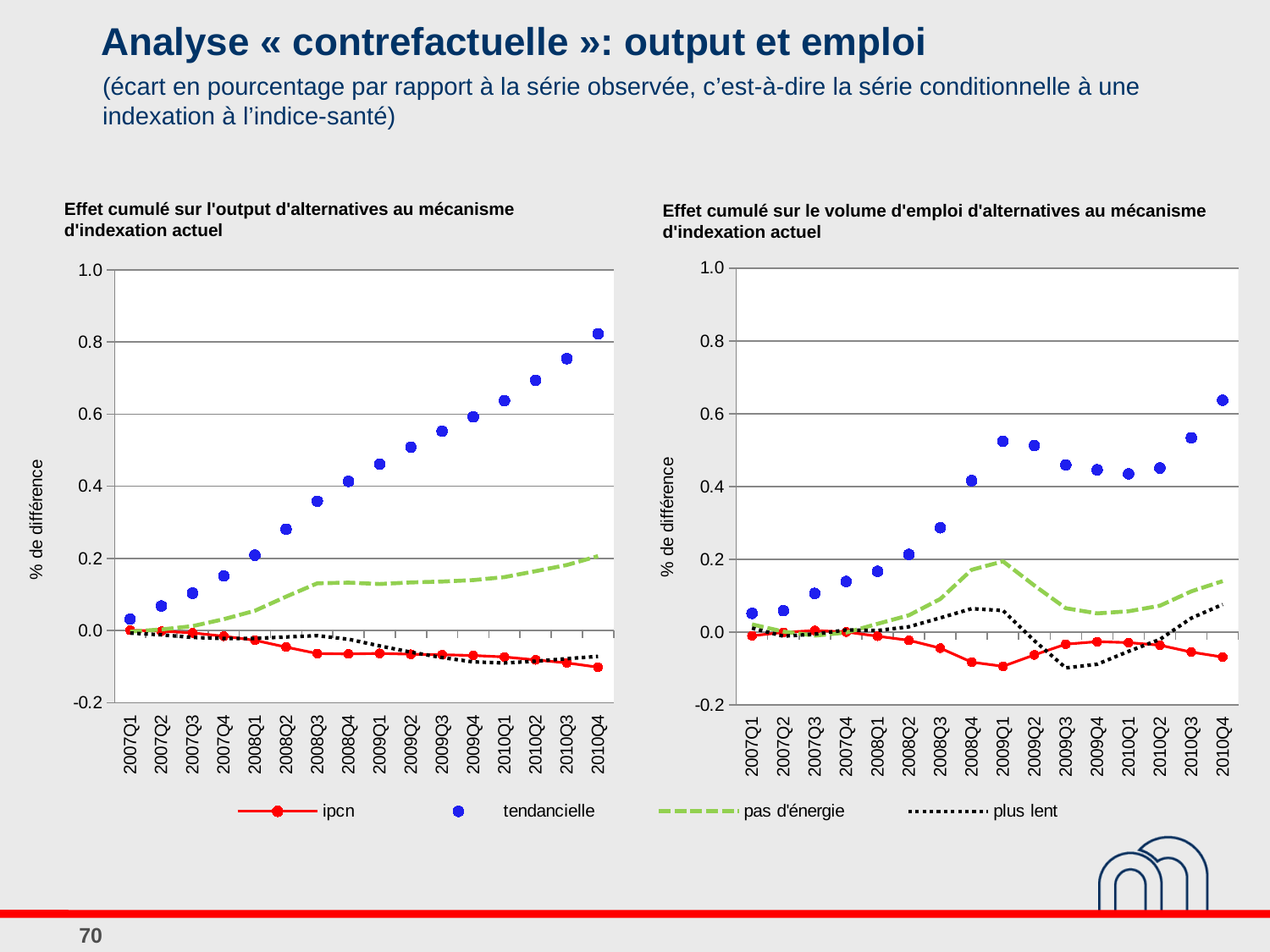
How many quarters are shown on the x axis of the right chart, 'Effet cumulé sur le volume d'emploi d'alternatives au mécanisme d'indexation actuel'? 16 In the right chart (volume d'emploi), is the value of the 'ipcn' series at 2010Q4 greater or less than 0.0? less Which is larger: the 'tendancielle' value at 2010Q4 in the left chart (output) or in the right chart (volume d'emploi)? left chart (output) In the right chart (volume d'emploi), is the value of the 'tendancielle' series at 2010Q4 greater or less than 0.6? greater How many series does the legend list for the charts? 4 What is the y-axis label of the left chart (output)? % de différence In the left chart (output), is the value of the 'tendancielle' series at 2010Q4 greater or less than 0.8? greater In the left chart (output), which series has the highest value at 2010Q4? tendancielle In the left chart (output), does the 'tendancielle' series rise or fall from 2007Q1 to 2010Q4? rise Which series is drawn with a green dashed line in the charts? pas d'énergie What kind of chart is the left chart, 'Effet cumulé sur l'output d'alternatives au mécanisme d'indexation actuel'? line chart